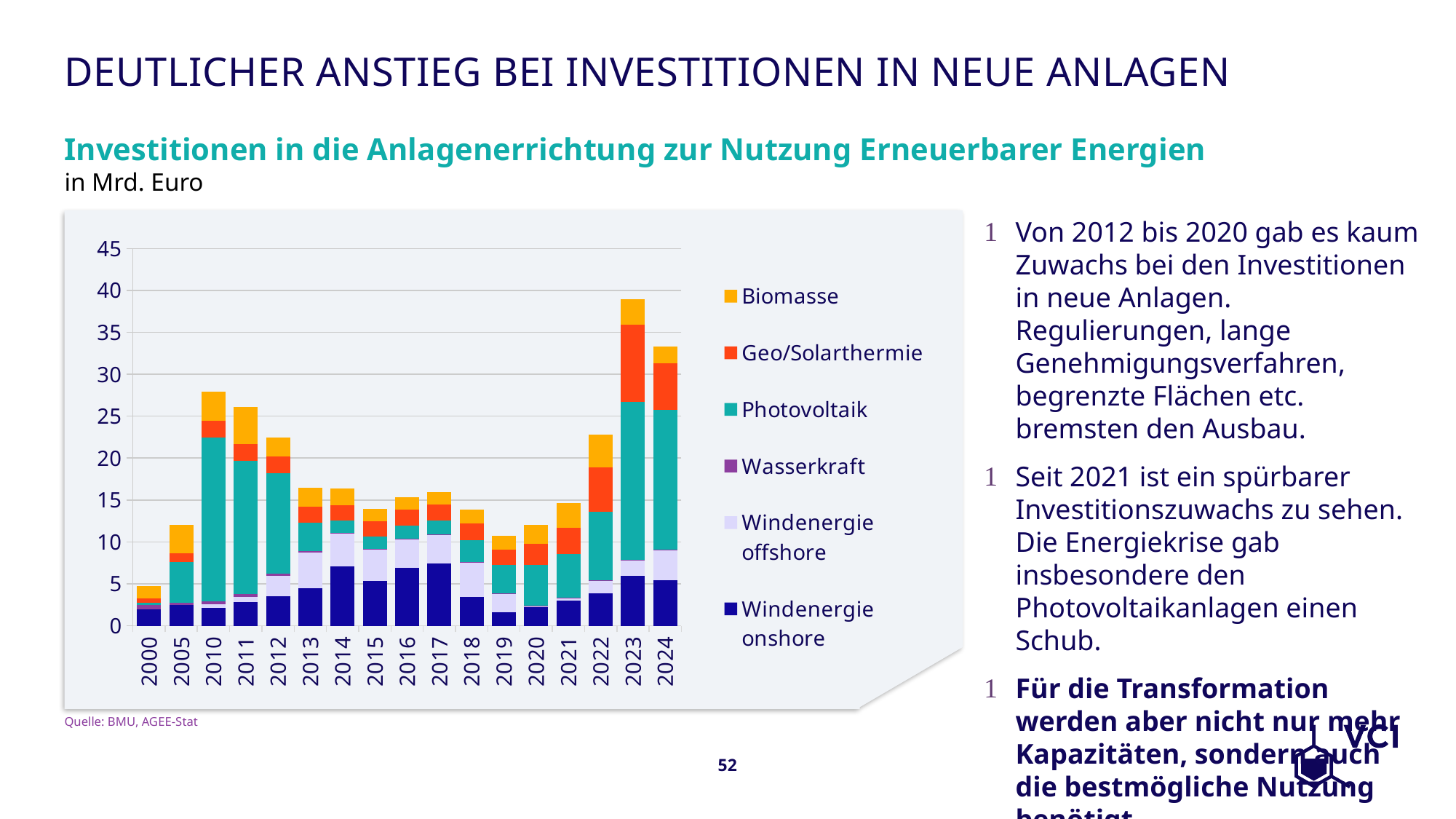
Which year has the larger total bar, 2005 or 2010? 2010 What kind of chart is shown on the slide? Stacked bar chart What is the unit given under the chart title? in Mrd. Euro How many series does the chart legend list? 6 Which year has the highest total investment in the chart? 2023 Is the total value for 2023 greater or less than 35? greater Which year has the lowest total investment in the chart? 2000 How many years are shown on the x axis of the chart? 17 Do the total investments rise or fall from 2021 to 2023? rise Which year has the larger total bar, 2023 or 2024? 2023 Is the total value for 2019 greater or less than 15? less Is the total value for 2010 greater or less than 25? greater